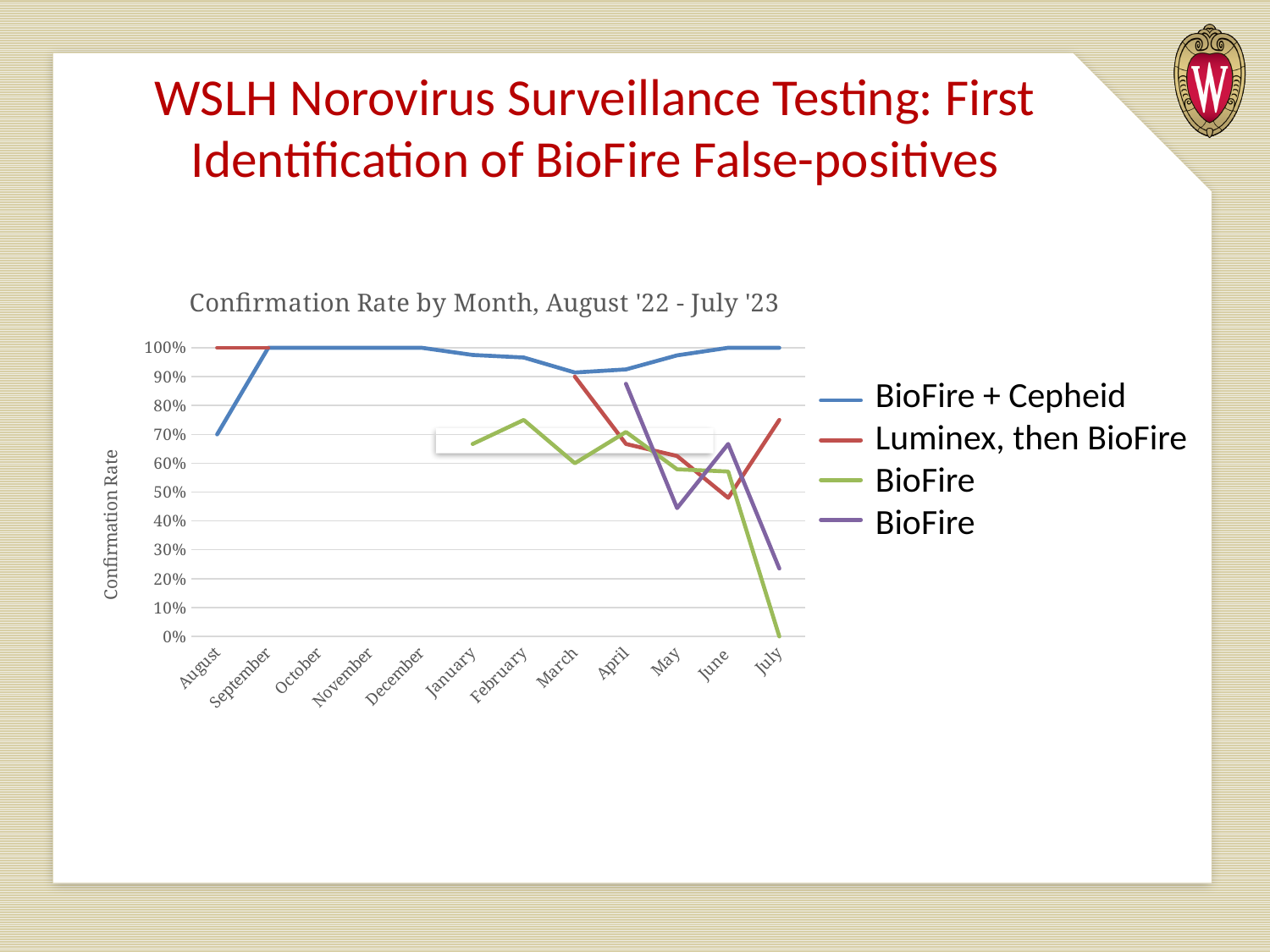
What is the confirmation rate for the green BioFire series in July? 0% What is the confirmation rate for BioFire + Cepheid in October? 100% What is the title of the chart? Confirmation Rate by Month, August '22 - July '23 Does the green BioFire series rise or fall from June to July? Fall What is the confirmation rate for Luminex, then BioFire in August? 100% Is the value for the purple BioFire series in May greater or less than 50%? less Is the value for BioFire + Cepheid in March greater or less than 80%? greater How many months are shown along the x axis? 12 How many series does the legend list? 4 Is the value for the purple BioFire series in July greater or less than 30%? less What kind of chart is shown on the slide? Line chart In July, which is larger: Luminex, then BioFire or the purple BioFire series? Luminex, then BioFire